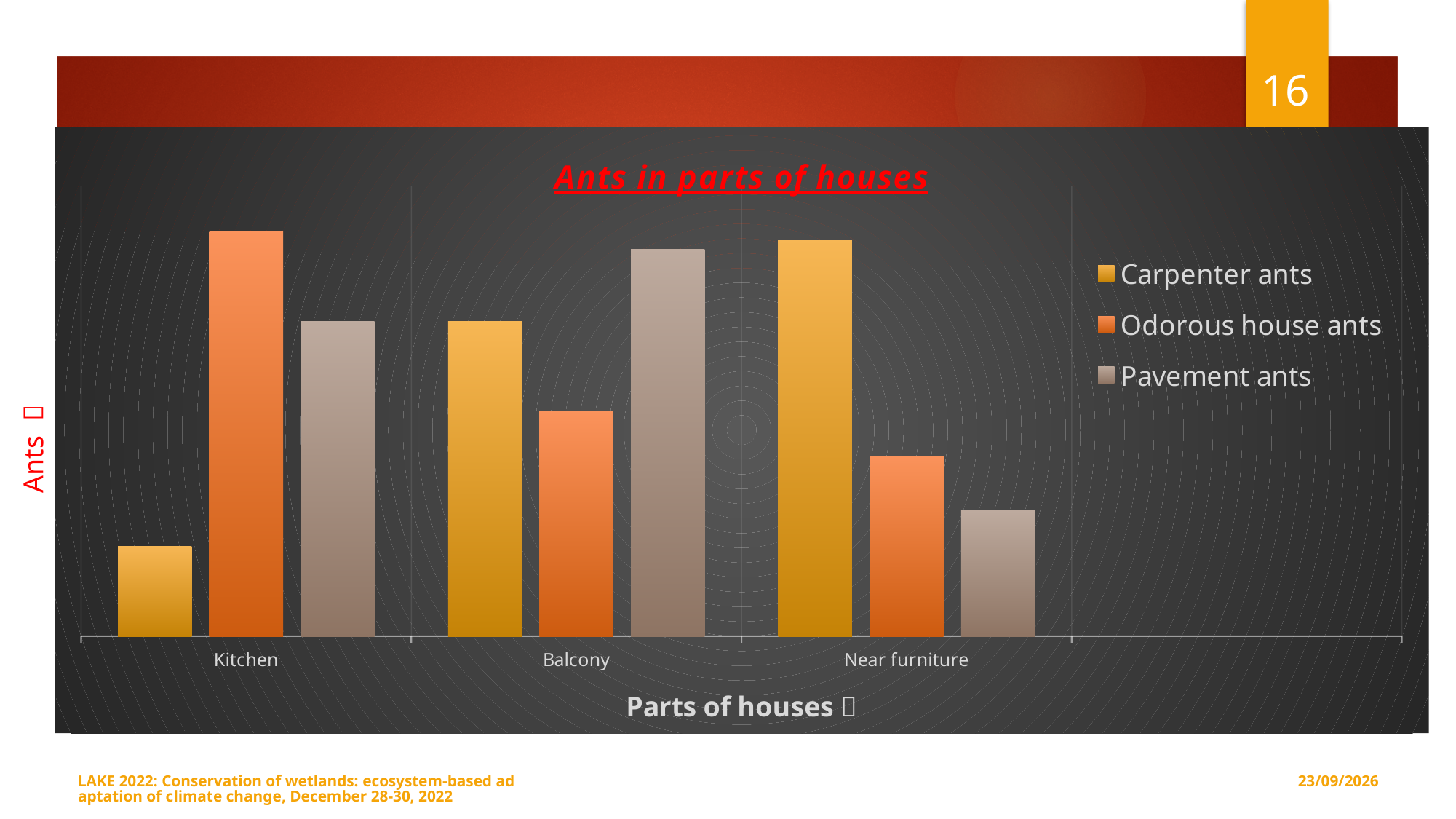
Which series has the lowest bar in the Near furniture category? Pavement ants How many parts of houses are shown on the x axis? 3 Do the Carpenter ants values rise or fall from Kitchen to Near furniture? rise What kind of chart is shown on the slide? bar chart What is the title of the chart? Ants in parts of houses Which is larger for Balcony: Carpenter ants or Odorous house ants? Carpenter ants Which series has the highest bar in the Near furniture category? Carpenter ants Which series has the lowest bar in the Kitchen category? Carpenter ants Which series has the highest bar in the Kitchen category? Odorous house ants Do the Odorous house ants values rise or fall from Kitchen to Near furniture? fall Which series has the highest bar in the Balcony category? Pavement ants How many series does the legend list? 3